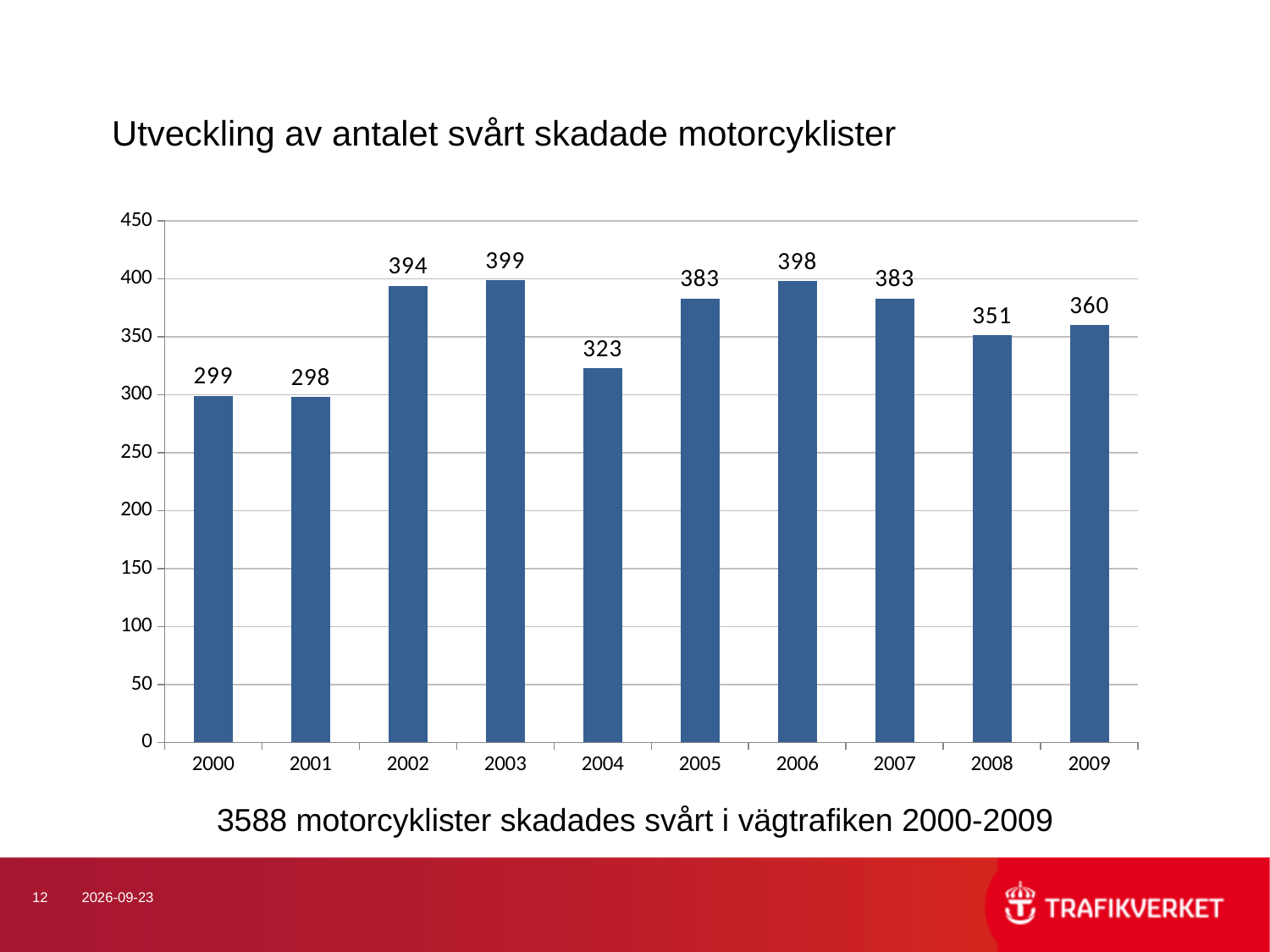
What kind of chart is shown on the slide? bar chart What is the value for 2008? 351 What is the difference between the values for 2003 and 2000? 100 Which year has the lowest value? 2001 What is the difference between the values for 2009 and 2008? 9 How many years are shown on the x axis? 10 Is the value for 2006 greater or less than 350? greater What is the value for 2003? 399 What is the value for 2004? 323 What is the title of the chart? Utveckling av antalet svårt skadade motorcyklister Which is larger, the value for 2002 or the value for 2004? 2002 Which year has the highest value? 2003